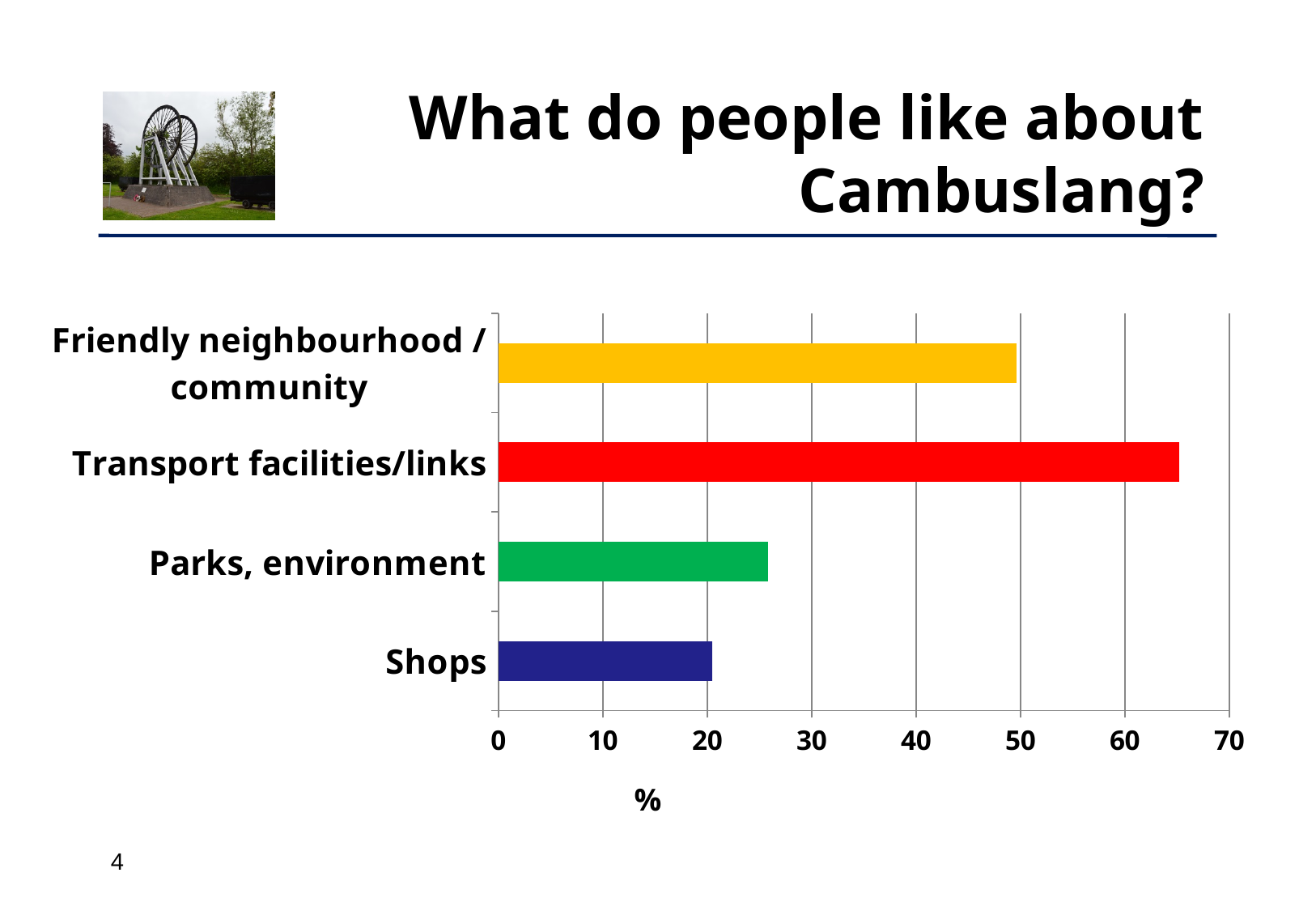
How many categories are shown in the chart? 4 What is the label on the horizontal axis of the chart? % Is the value for Parks, environment greater or less than 30? less Which is larger, the value for Friendly neighbourhood / community or the value for Parks, environment? Friendly neighbourhood / community Is the value for Parks, environment greater or less than 20? greater Is the value for Friendly neighbourhood / community greater or less than 40? greater Which category has the lowest value? Shops What kind of chart is shown on the slide? bar chart What is the title of the slide containing the chart? What do people like about Cambuslang? Which category has the highest value? Transport facilities/links